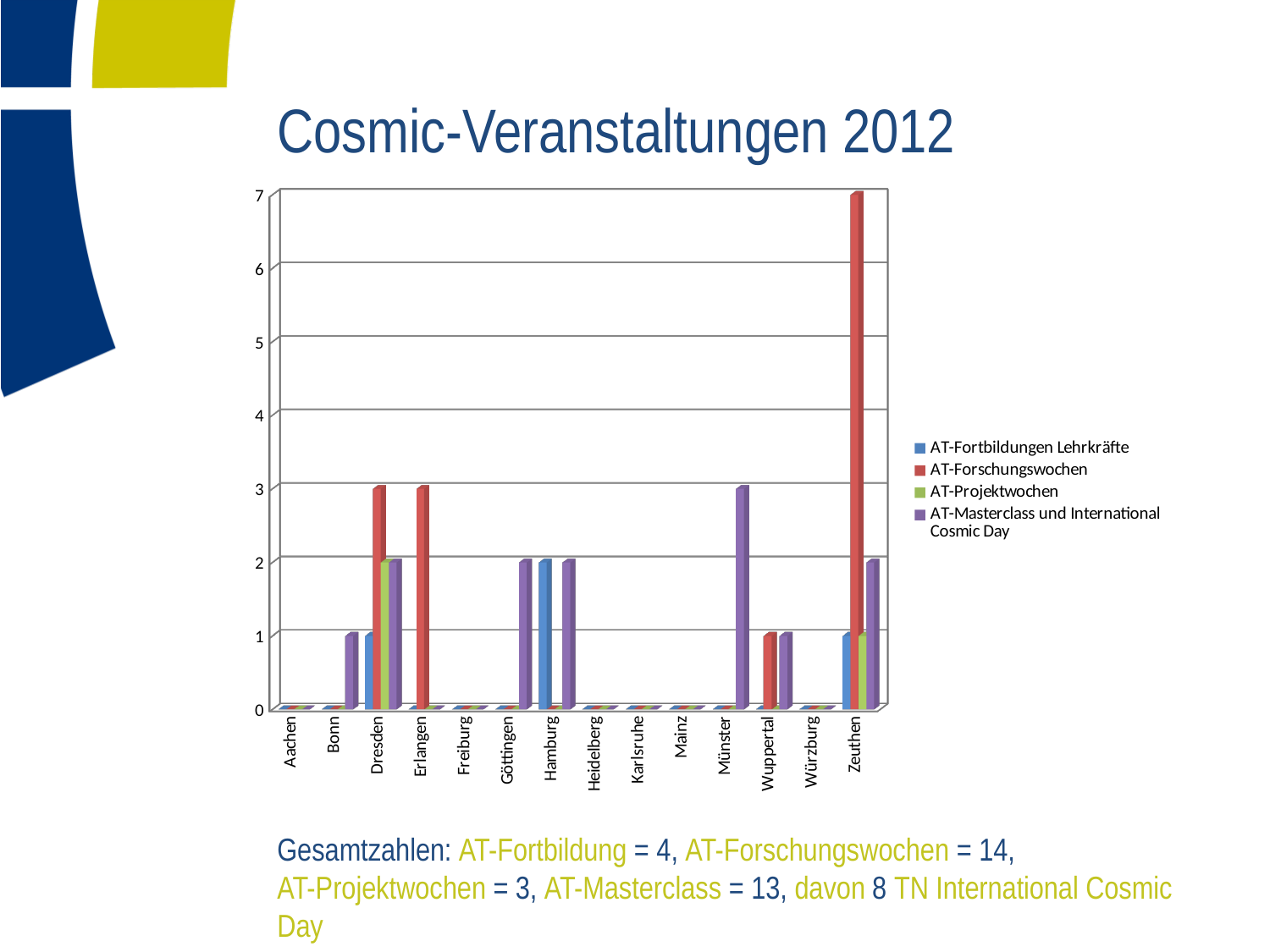
What is the value for AT-Fortbildungen Lehrkräfte in Hamburg? 2 What is the value for AT-Masterclass und International Cosmic Day in Münster? 3 Is the value for AT-Forschungswochen in Zeuthen greater or less than 5? greater Which is larger, AT-Forschungswochen in Zeuthen or AT-Forschungswochen in Erlangen? Zeuthen How many series does the legend list? 4 How many cities are shown on the x axis? 14 What kind of chart is shown on the slide? bar chart What is the value for AT-Forschungswochen in Dresden? 3 What is the difference between AT-Forschungswochen in Zeuthen and in Dresden? 4 What is the value for AT-Forschungswochen in Zeuthen? 7 What is the title of the chart? Cosmic-Veranstaltungen 2012 Which city has the highest value for AT-Forschungswochen? Zeuthen